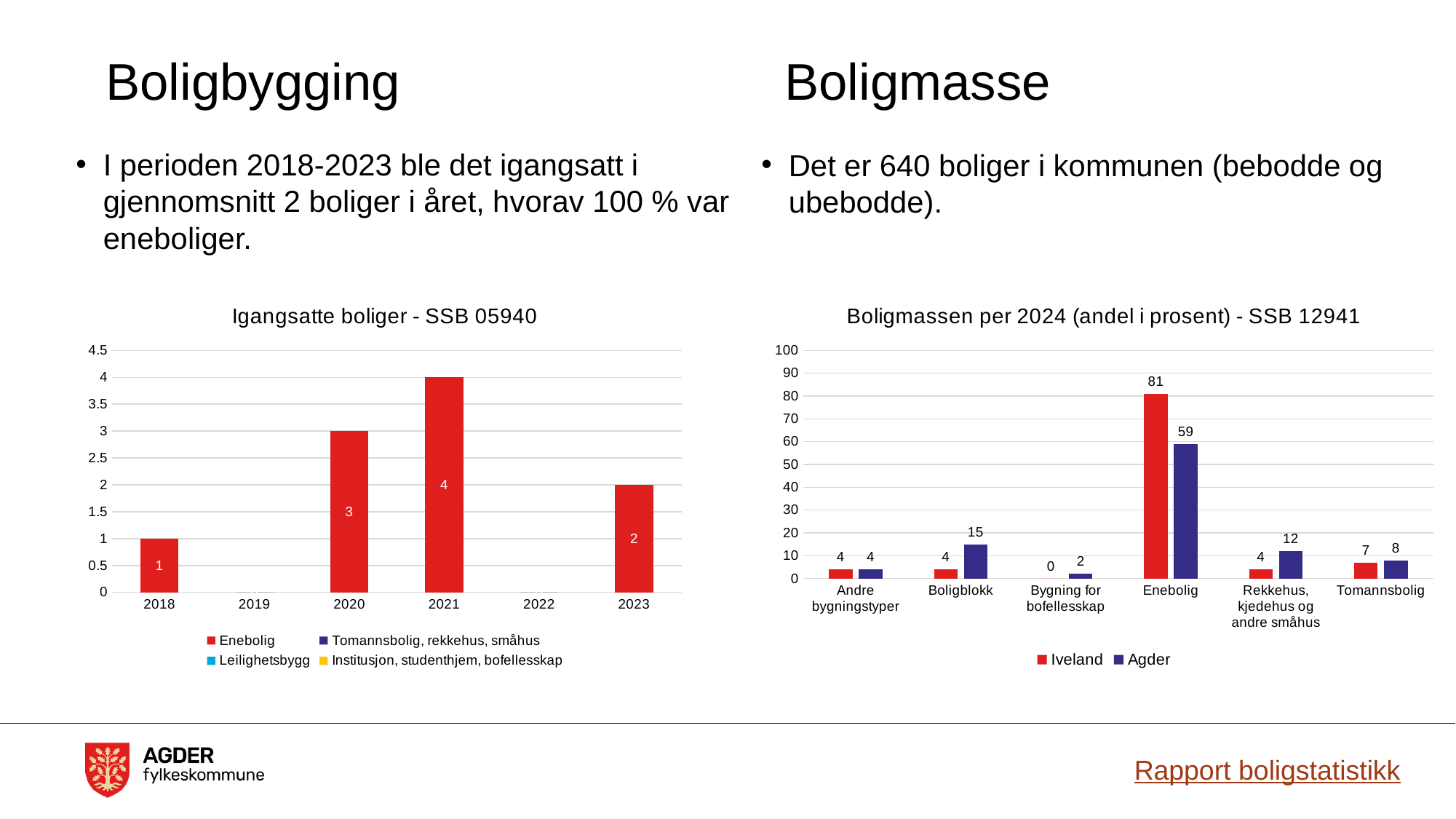
In the chart 'Igangsatte boliger - SSB 05940', which year has the highest value? 2021 In the chart 'Boligmassen per 2024 (andel i prosent) - SSB 12941', which category has the highest value for Agder? Enebolig In the chart 'Boligmassen per 2024 (andel i prosent) - SSB 12941', which is larger for Rekkehus, kjedehus og andre småhus: Iveland or Agder? Agder In the chart 'Boligmassen per 2024 (andel i prosent) - SSB 12941', what is the value for Iveland for Enebolig? 81 How many series does the legend of the chart 'Igangsatte boliger - SSB 05940' list? 4 In the chart 'Boligmassen per 2024 (andel i prosent) - SSB 12941', what is the value for Agder for Boligblokk? 15 What kind of chart is 'Igangsatte boliger - SSB 05940'? Bar chart In the chart 'Boligmassen per 2024 (andel i prosent) - SSB 12941', what is the difference between Iveland and Agder for Enebolig? 22 How many categories are shown on the x axis of the chart 'Boligmassen per 2024 (andel i prosent) - SSB 12941'? 6 In the chart 'Igangsatte boliger - SSB 05940', what is the difference between the values for 2020 and 2018? 2 In the chart 'Igangsatte boliger - SSB 05940', what is the value for Enebolig in 2021? 4 Which two series does the legend of the chart 'Boligmassen per 2024 (andel i prosent) - SSB 12941' list? Iveland and Agder